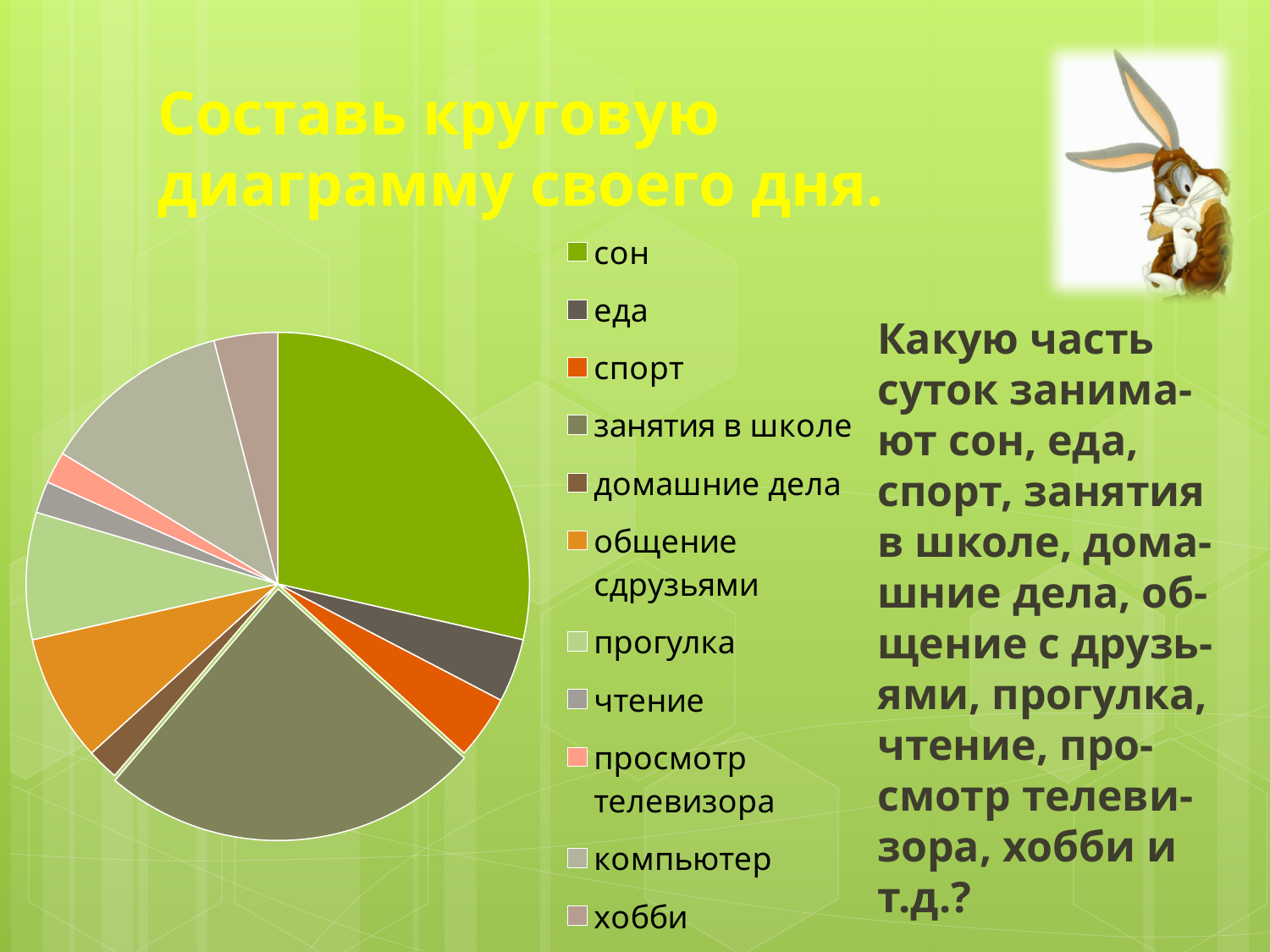
What colour is the slice for сон in the pie chart? green Which slice is larger, сон or занятия в школе? сон What kind of chart is shown on the slide? pie chart Which slice is larger, общение сдрузьями or домашние дела? общение сдрузьями Which slice is larger, сон or еда? сон How many categories (slices) does the pie chart have? 11 Which category has the largest slice in the pie chart? сон What is the title of the slide containing the pie chart? Составь круговую диаграмму своего дня.